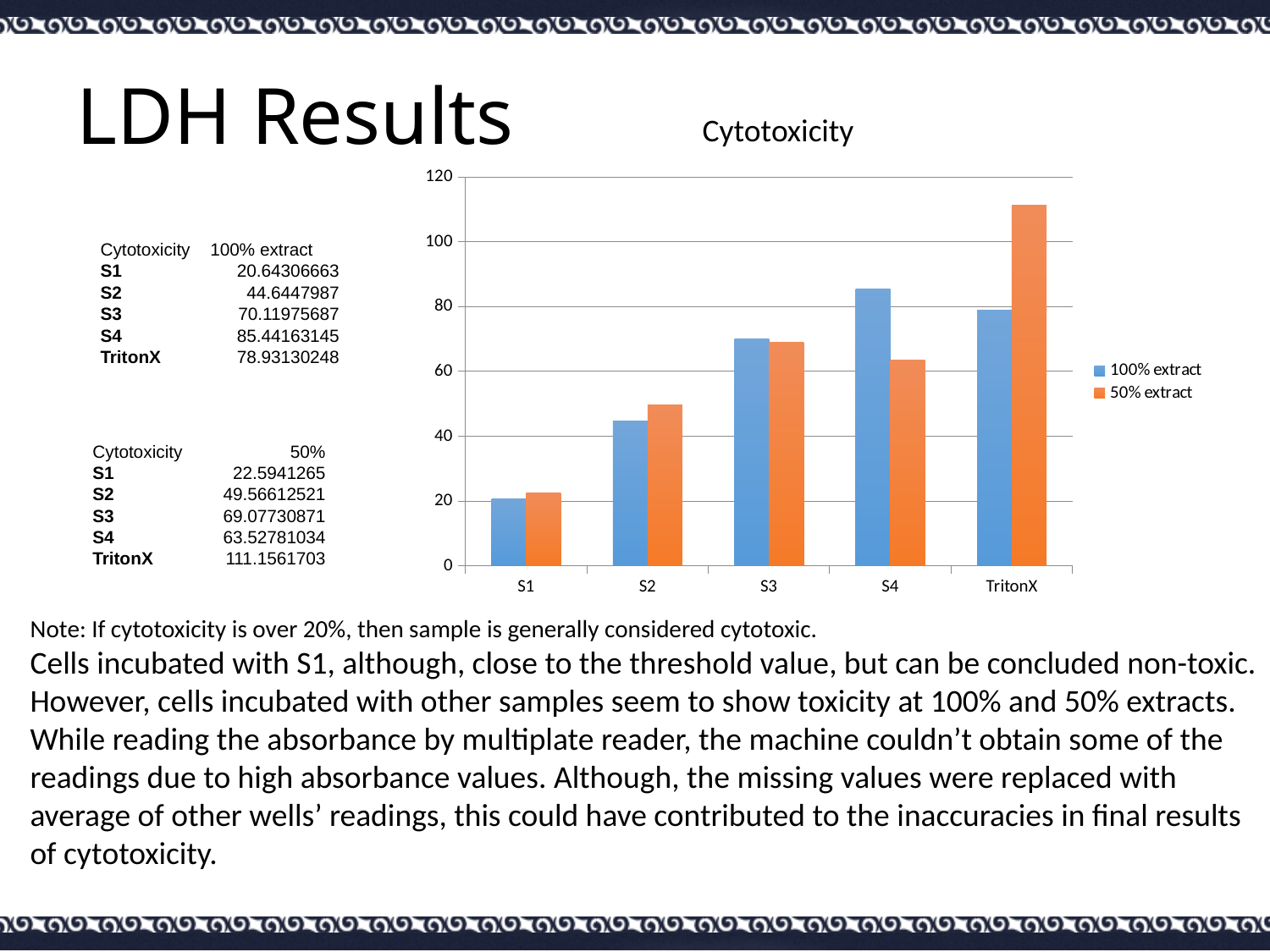
What is the 50% extract cytotoxicity value for TritonX? 111.1561703 Is the 100% extract value for S2 greater or less than 40? greater Is the 50% extract value for TritonX greater or less than 100? greater How many categories are shown on the x axis of the Cytotoxicity chart? 5 What kind of chart is the Cytotoxicity chart? bar chart Do the 100% extract values rise or fall from S1 to S4? rise How many series does the legend of the Cytotoxicity chart list? 2 Which category has the highest value for the 100% extract series? S4 Which category has the lowest value for the 100% extract series? S1 For S4, which series has the larger value, 100% extract or 50% extract? 100% extract What is the 100% extract cytotoxicity value for S3? 70.11975687 Which category has the highest value for the 50% extract series? TritonX